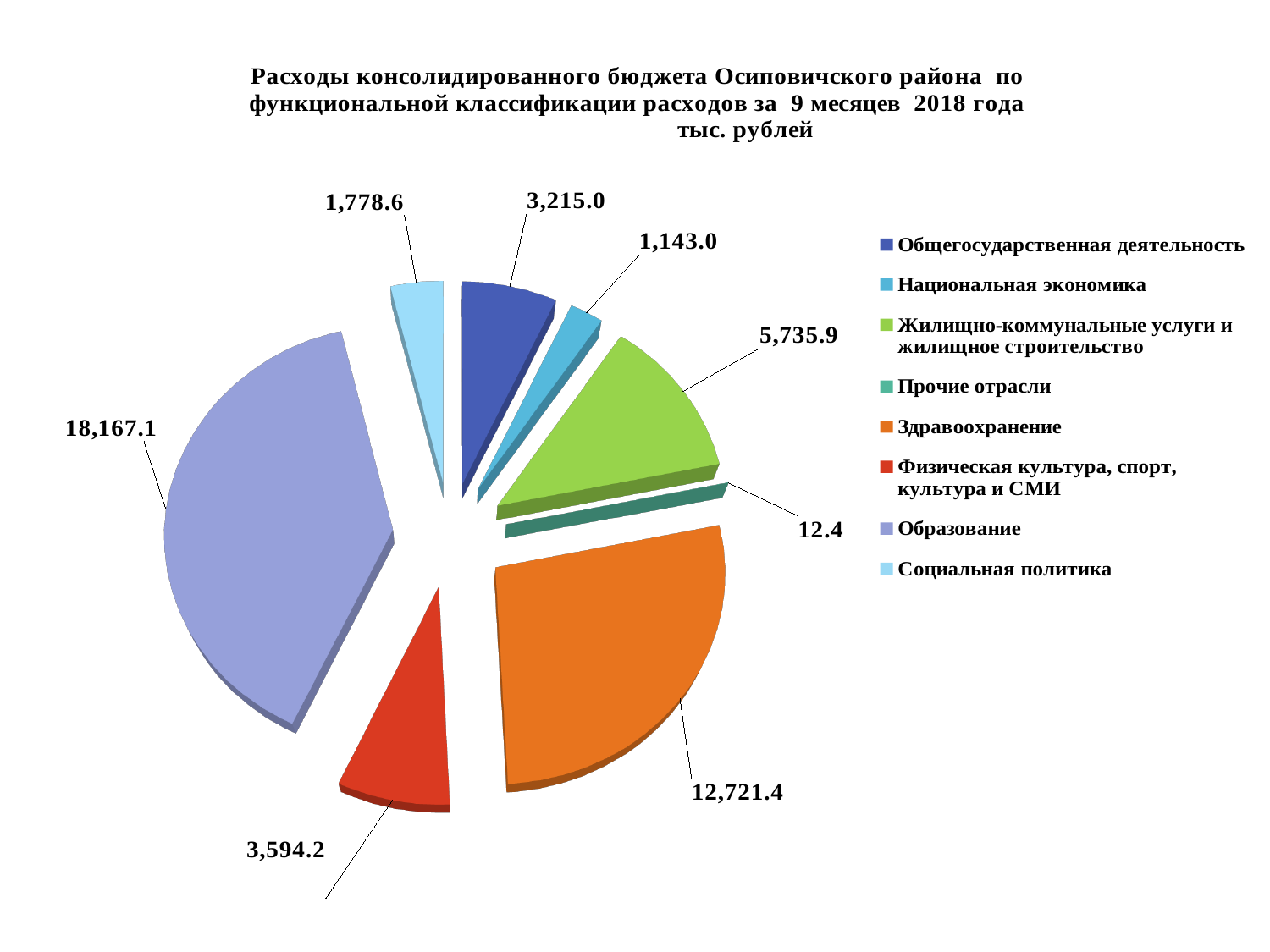
Which category has the largest value? Образование What is the value for Образование? 18,167.1 Which category has the smallest value? Прочие отрасли What type of chart is shown on the slide? Pie chart What is the difference between the values for Образование and Здравоохранение? 5,445.7 What is the value for Здравоохранение? 12,721.4 What is the value for Жилищно-коммунальные услуги и жилищное строительство? 5,735.9 How many categories does the pie chart have? 8 What colour is the slice for Здравоохранение? Orange Which is larger: Физическая культура, спорт, культура и СМИ or Общегосударственная деятельность? Физическая культура, спорт, культура и СМИ What is the value for Прочие отрасли? 12.4 What is the value for Социальная политика? 1,778.6